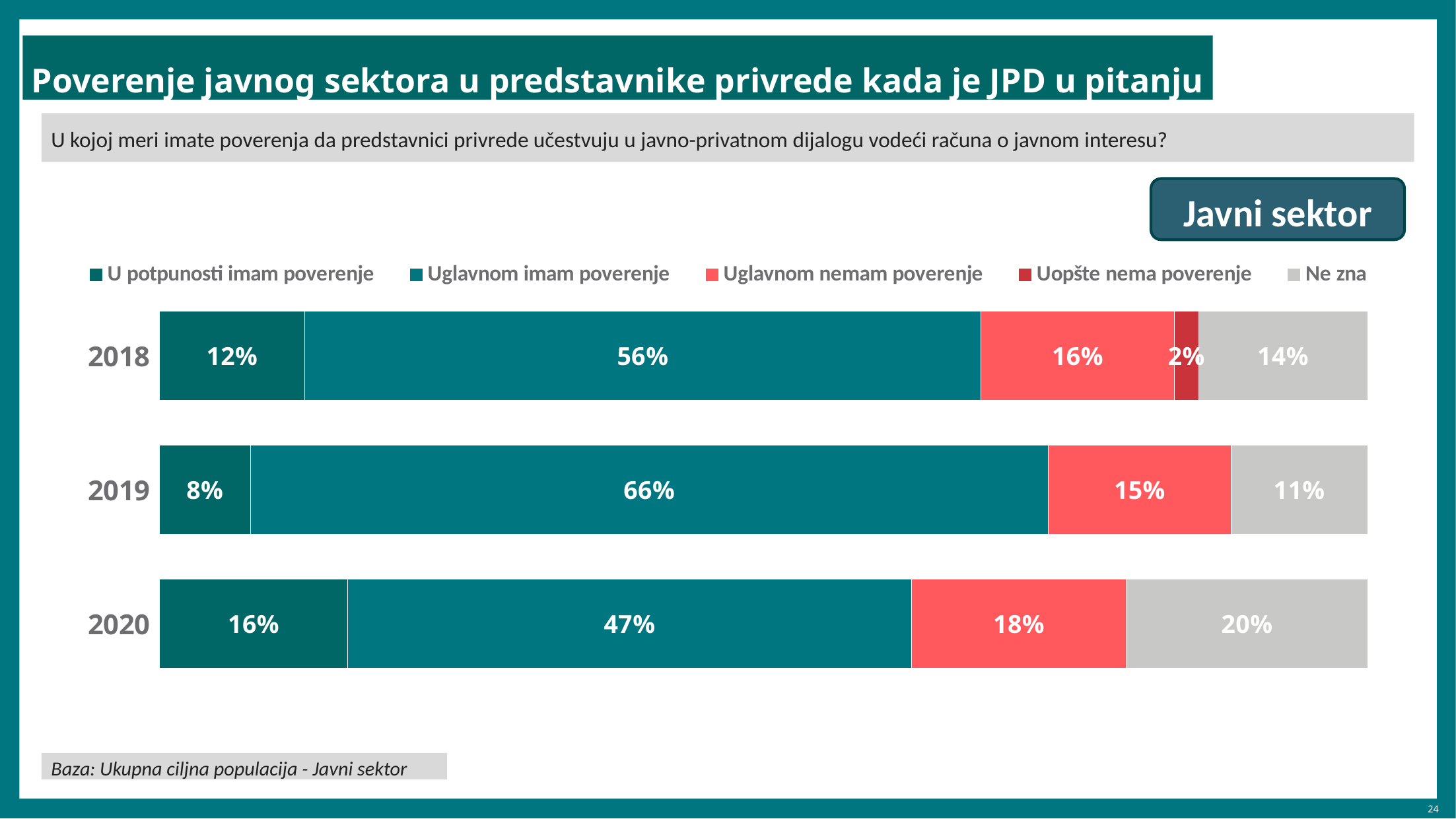
What is the difference between the 'Uglavnom imam poverenje' values for 2019 and 2020? 19% How many series does the legend list? 5 What kind of chart is shown on the slide? stacked bar chart What is the value for 'Uopšte nema poverenje' in 2018? 2% What is the value for 'U potpunosti imam poverenje' in 2020? 16% What is the value for 'Uglavnom imam poverenje' in 2019? 66% Which year has the highest value for 'Uglavnom imam poverenje'? 2019 How many years (categories) are shown in the chart? 3 What is the total of the 2018 stacked bar? 100% Which year has the lowest value for 'U potpunosti imam poverenje'? 2019 What is the value for 'Ne zna' in 2018? 14% Which is larger: 'Ne zna' in 2020 or 'Ne zna' in 2019? 2020